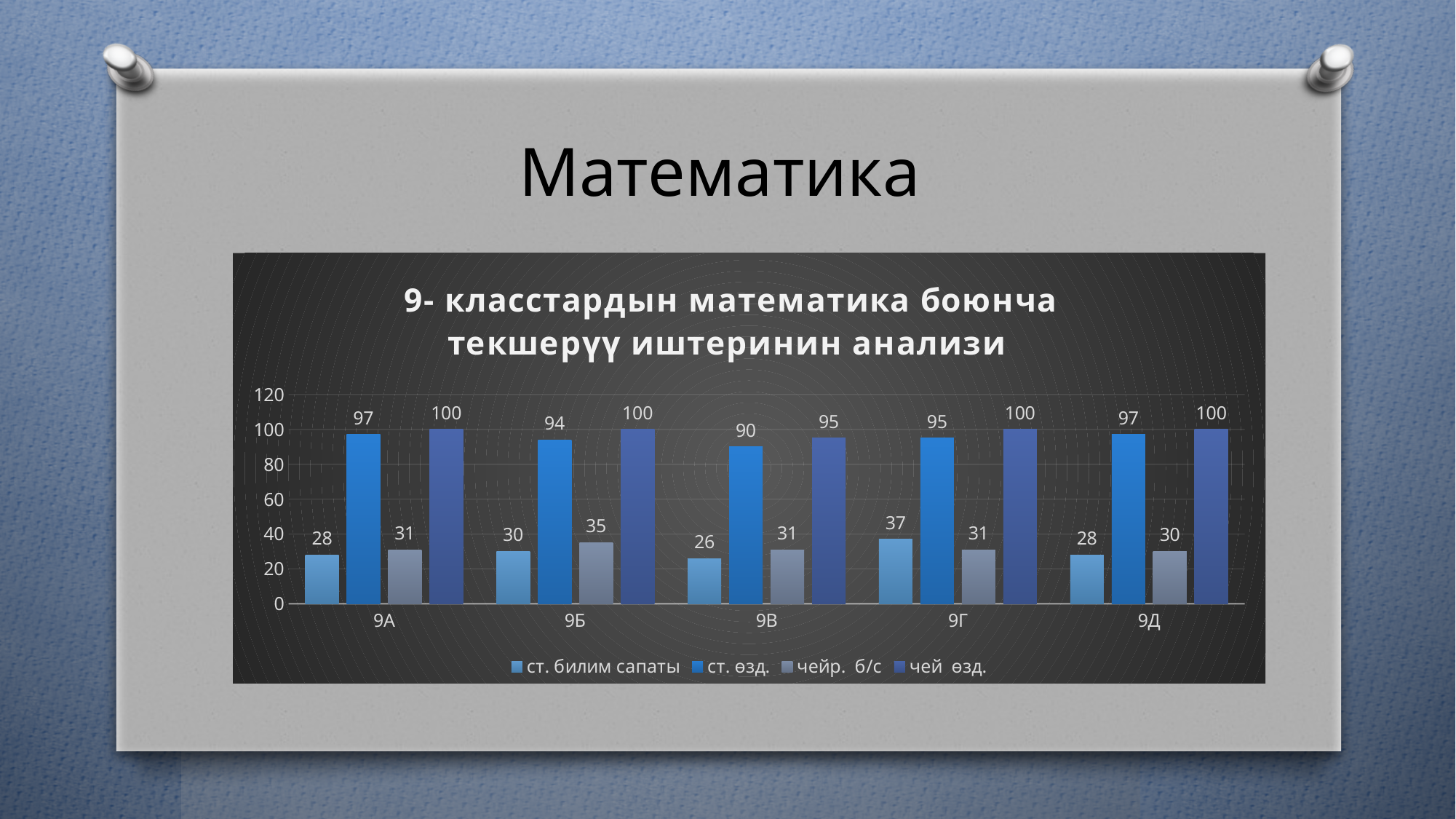
Which is larger: the "чейр. б/с" value for 9Б or for 9Д? 9Б What is the value of "ст. билим сапаты" for 9Г? 37 What kind of chart is shown on the slide? Bar chart Which class has the lowest value for "ст. өзд."? 9В What is the difference between the "ст. өзд." values for 9А and 9Б? 3 How many series does the legend list? 4 Which class has the highest value for "ст. билим сапаты"? 9Г What is the value of "чей өзд." for 9В? 95 What is the value of "ст. өзд." for 9В? 90 What is the title of the chart? 9- класстардын математика боюнча текшерүү иштеринин анализи What is the value of "чейр. б/с" for 9Б? 35 How many classes are shown on the x axis? 5